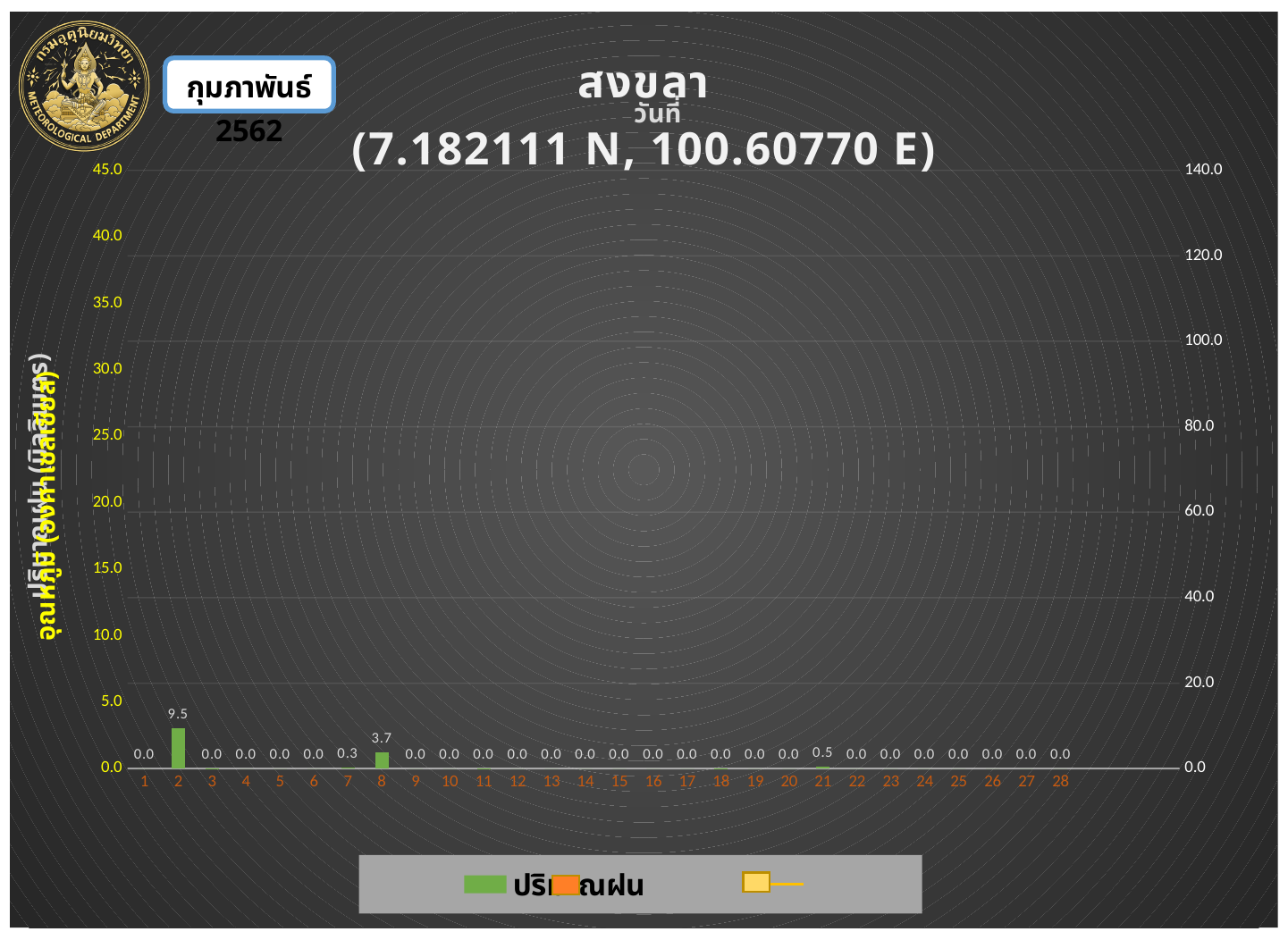
What is the rainfall value shown for day 2? 9.5 How many days are shown on the x axis? 28 What kind of chart is used to show the rainfall values? bar chart What is the difference between the rainfall values for day 2 and day 8? 5.8 What is the rainfall value shown for day 7? 0.3 What is the rainfall value shown for day 21? 0.5 Which has the larger rainfall value, day 8 or day 21? day 8 What is the rainfall value shown for day 8? 3.7 What is the highest tick value on the left vertical axis? 45.0 Which day has the highest rainfall value? 2 What is the highest tick value on the right vertical axis? 140.0